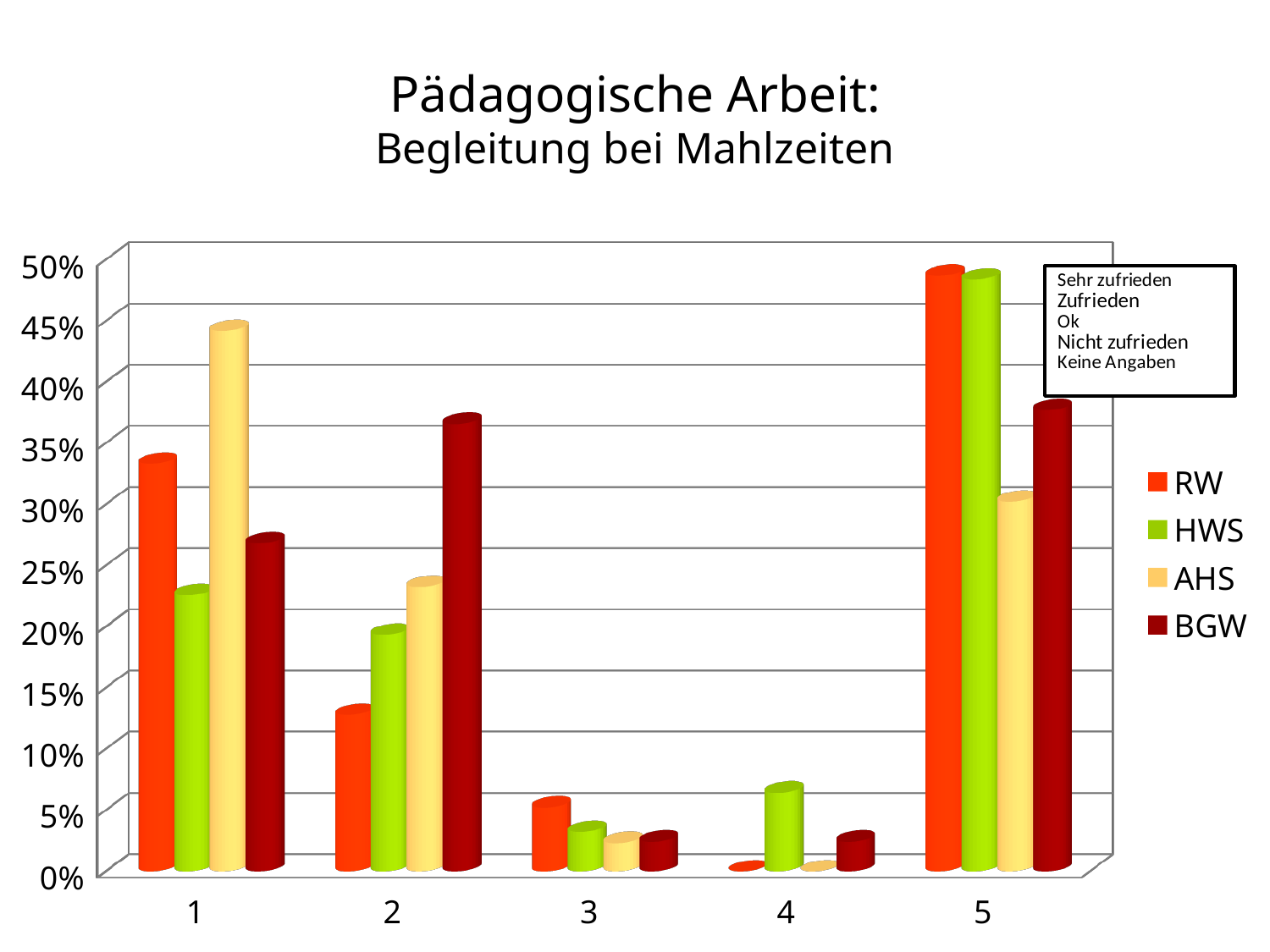
How many series does the legend list? 4 In category 4, which is larger: the HWS value or the BGW value? HWS Is the AHS value for category 5 greater or less than 35%? less For which category is the HWS value lowest? 3 Which series has the highest value in category 2? BGW Is the AHS value for category 1 greater or less than 40%? greater What kind of chart is shown on the slide? bar chart In category 1, which is larger: the AHS value or the RW value? AHS For which category is the AHS value highest? 1 Is the RW value for category 2 greater or less than 15%? less What is the title of the chart? Pädagogische Arbeit: Begleitung bei Mahlzeiten How many categories are shown on the x axis? 5